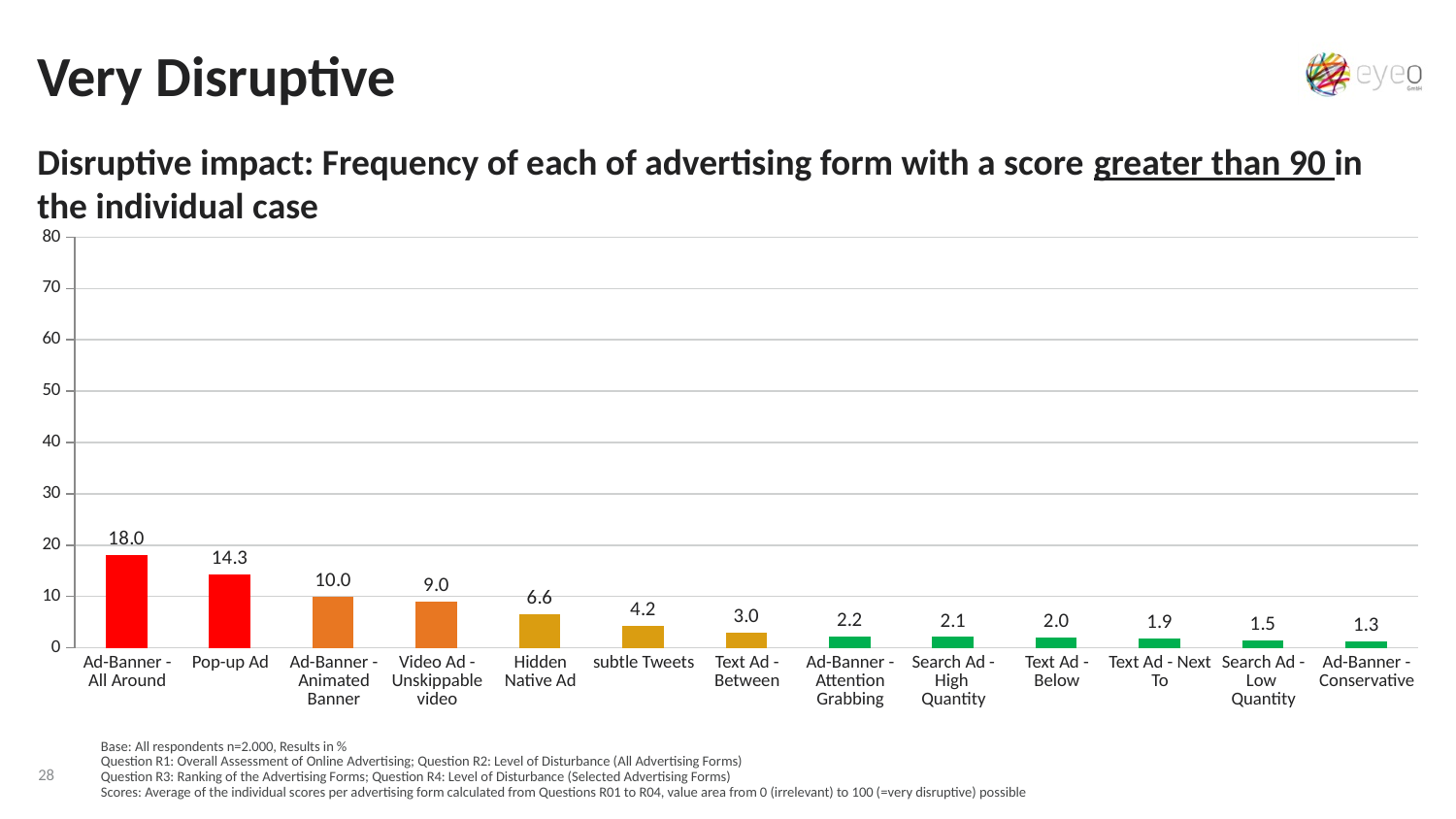
What kind of chart is shown on the slide? bar chart Is the value for Ad-Banner - All Around greater or less than 20? less What is the value for Search Ad - Low Quantity? 1.5 Which advertising form has the lowest value? Ad-Banner - Conservative What is the value for Pop-up Ad? 14.3 What is the difference between the values for Ad-Banner - All Around and Pop-up Ad? 3.7 Which advertising form has the highest value? Ad-Banner - All Around Which is larger, the value for subtle Tweets or the value for Text Ad - Between? subtle Tweets What is the value for Hidden Native Ad? 6.6 Do the values rise or fall from left to right along the x axis? fall How many advertising forms are shown on the x axis? 13 What is the difference between the values for Ad-Banner - Animated Banner and Video Ad - Unskippable video? 1.0